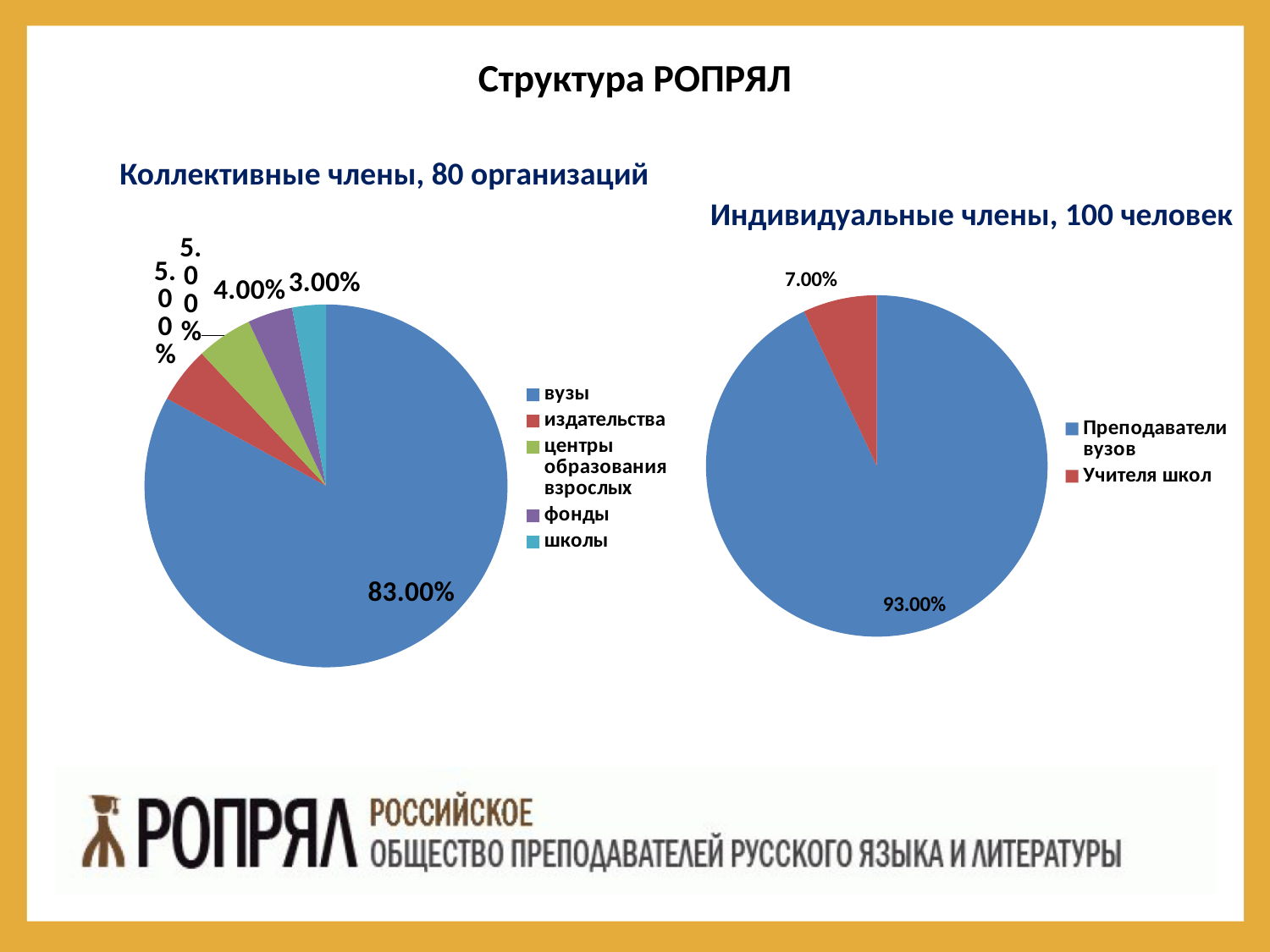
In the 'Коллективные члены, 80 организаций' chart, which category has the largest slice? вузы In the 'Коллективные члены, 80 организаций' chart, what share does 'издательства' have? 5.00% In the 'Коллективные члены, 80 организаций' chart, what share does 'фонды' have? 4.00% In the 'Коллективные члены, 80 организаций' chart, what share does 'школы' have? 3.00% In the 'Индивидуальные члены, 100 человек' chart, what share does 'Преподаватели вузов' have? 93.00% What type of chart is used for 'Коллективные члены, 80 организаций'? pie chart How many categories does the legend of the 'Коллективные члены, 80 организаций' chart list? 5 In the 'Индивидуальные члены, 100 человек' chart, which is larger: 'Преподаватели вузов' or 'Учителя школ'? Преподаватели вузов In the 'Коллективные члены, 80 организаций' chart, what share does 'вузы' have? 83.00% In the 'Коллективные члены, 80 организаций' chart, what is the difference between the shares of 'фонды' and 'школы'? 1.00% In the 'Индивидуальные члены, 100 человек' chart, what share does 'Учителя школ' have? 7.00% In the 'Коллективные члены, 80 организаций' chart, which category has the smallest slice? школы